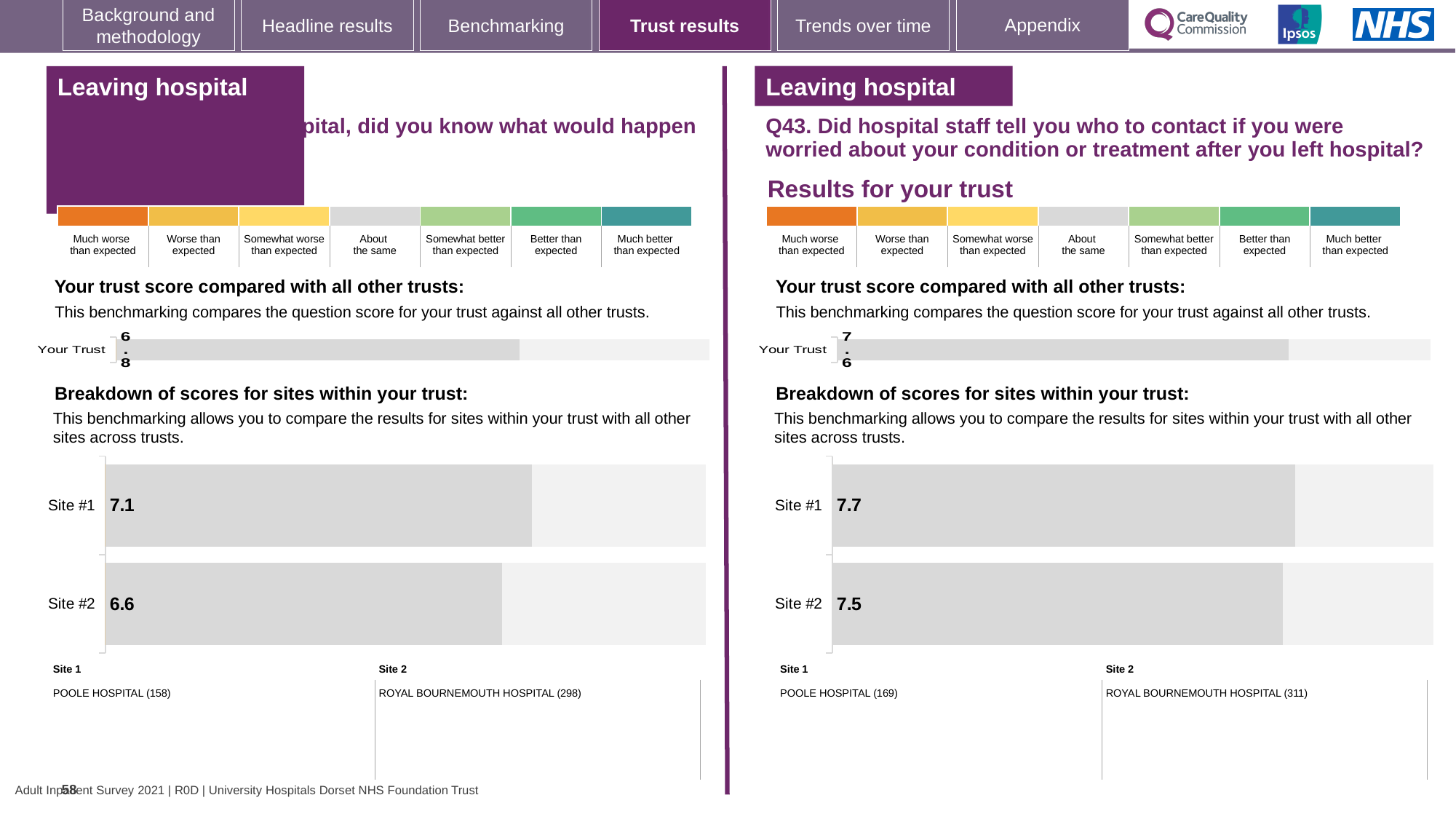
How many sites are shown in the Q43 site breakdown chart on the right-hand side of the slide? 2 In the Q43 chart on the right-hand side of the slide, what is the score shown for Site #2? 7.5 On the left-hand side of the slide, what is the 'Your Trust' score in the trust score comparison chart? 6.8 In the Q43 site breakdown chart on the right-hand side of the slide, which site has the lower score? Site #2 In the Q43 chart on the right-hand side of the slide, what is the score shown for Site #1? 7.7 In the Q43 site breakdown chart on the right-hand side of the slide, what is the difference between the Site #1 and Site #2 scores? 0.2 On the left-hand side of the slide, which site has the higher score in the breakdown of scores for sites within your trust? Site #1 On the left-hand side of the slide, what is the score shown for Site #2 in the breakdown of scores for sites within your trust? 6.6 In the Q43 section on the right-hand side of the slide, what is the 'Your Trust' score in the trust score comparison chart? 7.6 What type of chart is used for the breakdown of scores for sites within your trust on the right-hand side of the slide? Bar chart On the left-hand side of the slide, what is the score shown for Site #1 in the breakdown of scores for sites within your trust? 7.1 On the left-hand side of the slide, what is the difference between the Site #1 and Site #2 scores in the site breakdown chart? 0.5